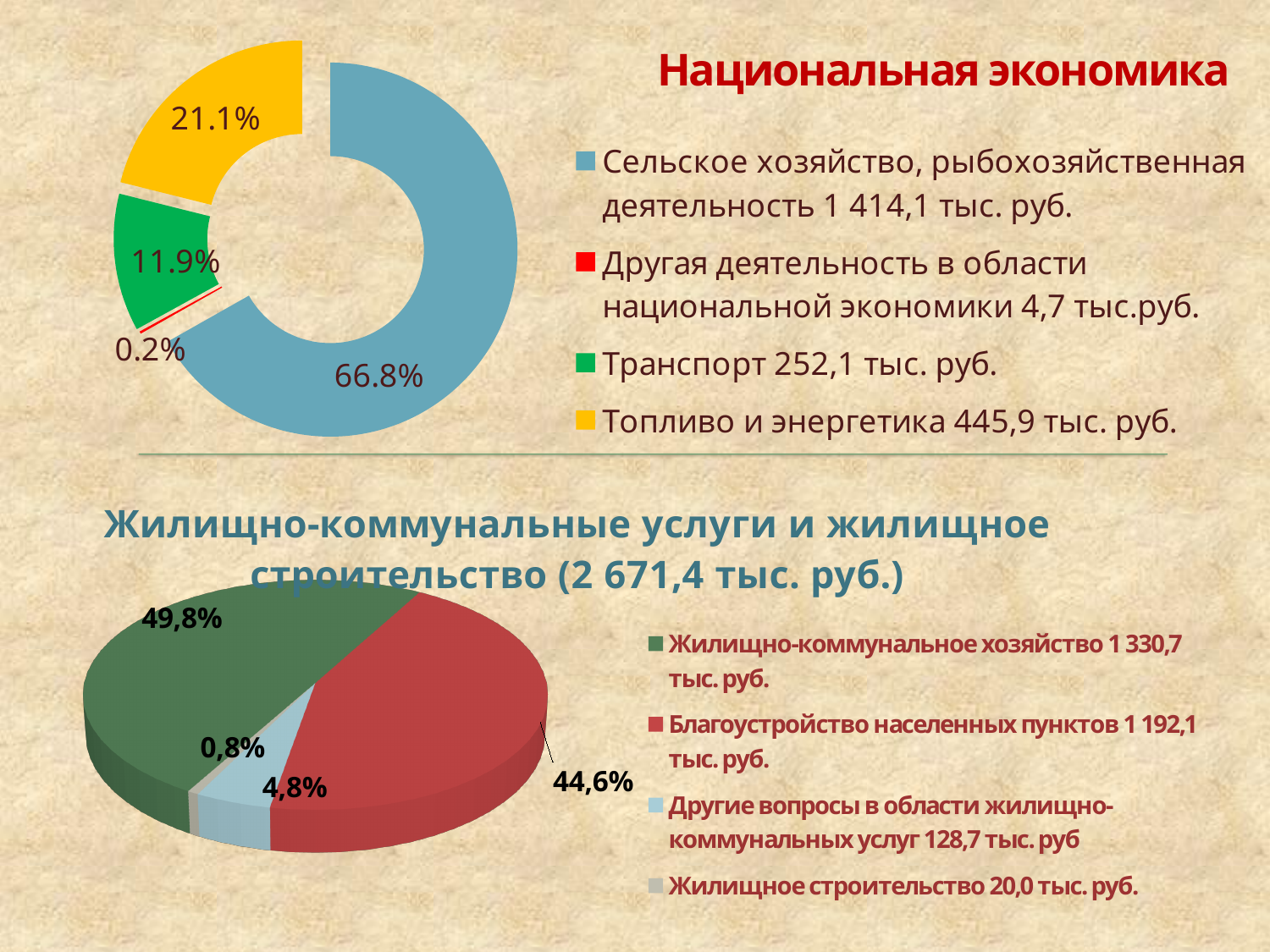
What kind of chart is the 'Жилищно-коммунальные услуги и жилищное строительство' chart? Pie chart In the 'Национальная экономика' chart, what percentage share is shown for Транспорт? 11.9% In the 'Национальная экономика' chart, how many categories does the legend list? 4 In the 'Жилищно-коммунальные услуги и жилищное строительство' chart, what percentage share is shown for Благоустройство населенных пунктов? 44,6% In the 'Национальная экономика' chart, what amount in тыс. руб. is given in the legend for Транспорт? 252,1 тыс. руб. What kind of chart is the 'Национальная экономика' chart? Doughnut chart In the 'Национальная экономика' chart, which category has the largest share? Сельское хозяйство, рыбохозяйственная деятельность In the 'Жилищно-коммунальные услуги и жилищное строительство' chart, what percentage share is shown for Жилищное строительство? 0,8% In the 'Национальная экономика' chart, what percentage share is shown for Топливо и энергетика? 21.1% In the 'Жилищно-коммунальные услуги и жилищное строительство' chart, which category has the largest share? Жилищно-коммунальное хозяйство In the 'Жилищно-коммунальные услуги и жилищное строительство' chart, which is larger: the share for Другие вопросы в области жилищно-коммунальных услуг or the share for Жилищное строительство? Другие вопросы в области жилищно-коммунальных услуг In the 'Национальная экономика' chart, which category has the smallest share? Другая деятельность в области национальной экономики